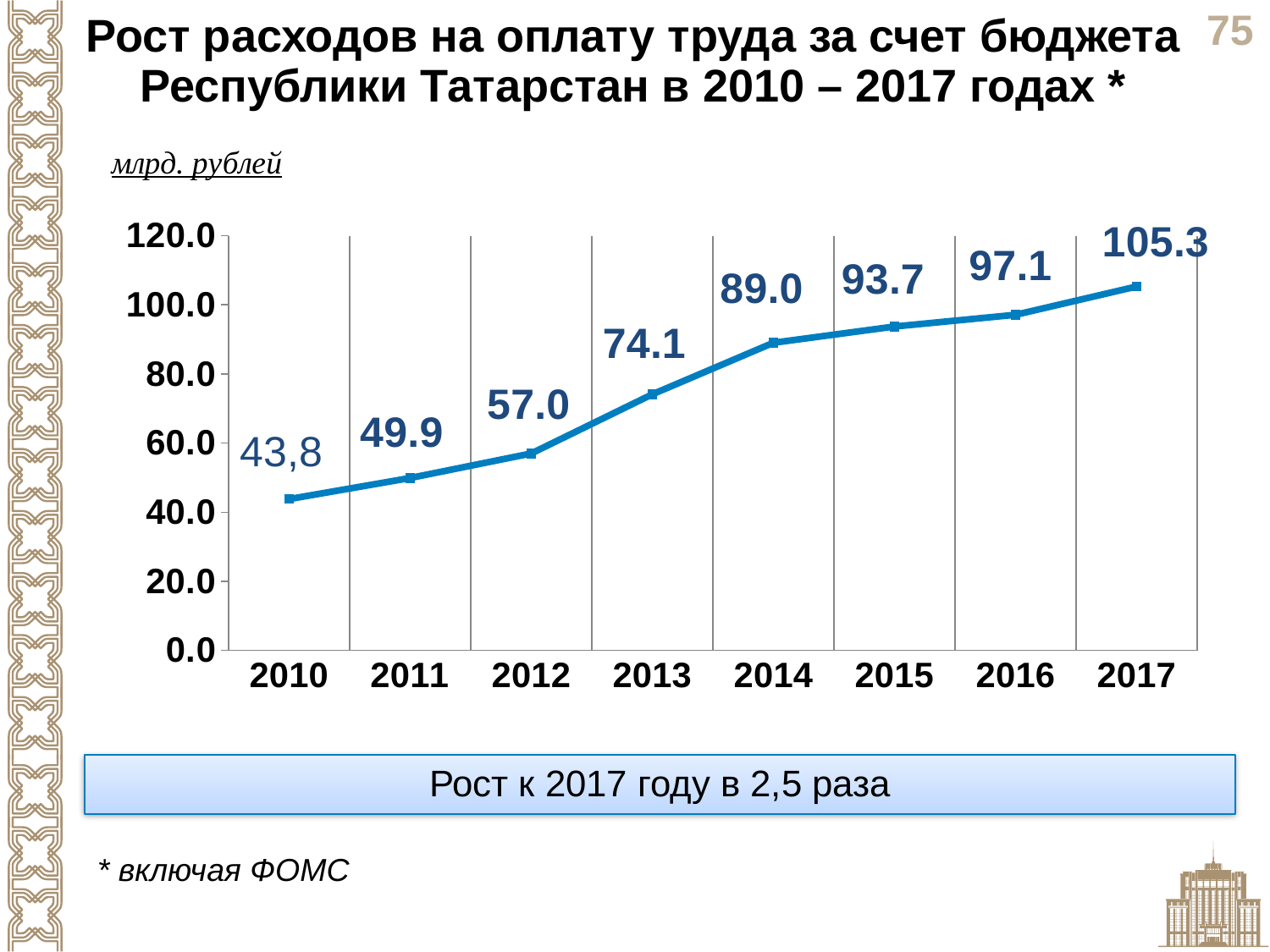
What is the difference between the values for 2014 and 2013? 14.9 What kind of chart is this? line chart What is the value for 2017? 105.3 How many years are shown on the x axis? 8 What is the value for 2010? 43,8 Do the values rise or fall from 2010 to 2017? rise What is the value for 2013? 74.1 Which year has the lowest value? 2010 Is the value for 2016 greater or less than 80.0? greater What unit is stated above the chart? млрд. рублей Which year has the highest value? 2017 Which is larger, the value for 2015 or the value for 2012? 2015